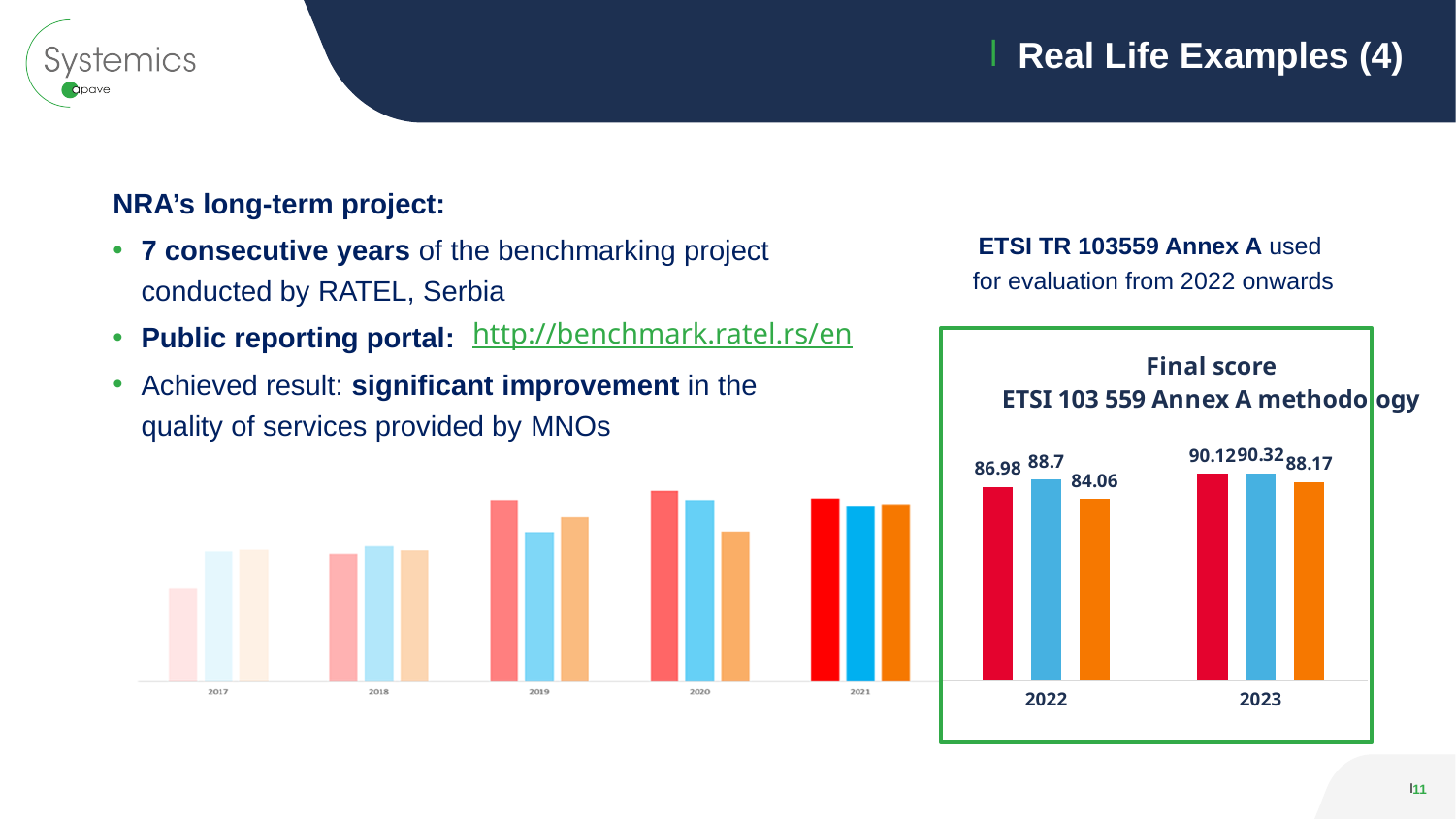
Is the red bar larger in 2022 or in 2023? 2023 Which bar has the highest value in 2023? blue (90.32) What is the difference between the orange bar in 2023 and the orange bar in 2022? 4.11 What is the value of the orange bar for 2023? 88.17 What is the difference between the blue bar and the red bar in 2022? 1.72 What is the value of the blue bar for 2022? 88.7 What is the value of the blue bar for 2023? 90.32 What kind of chart is shown on the slide? bar chart What is the title of the chart inside the green box? Final score ETSI 103 559 Annex A methodology Which bar has the lowest value in 2022? orange (84.06) What is the value of the red bar for 2022? 86.98